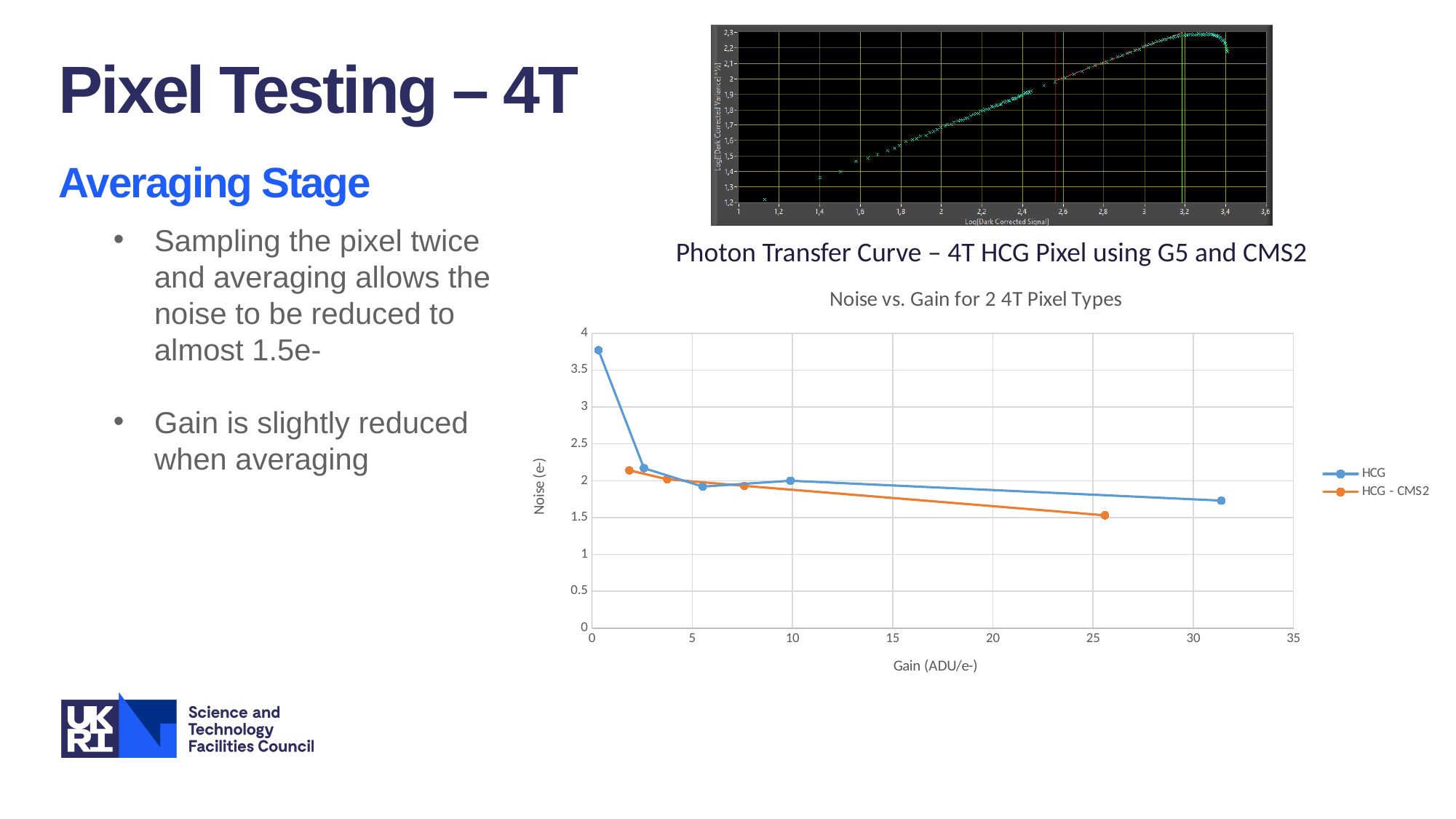
In the 'Noise vs. Gain for 2 4T Pixel Types' chart, how many data points are plotted for the HCG series? 5 In the 'Noise vs. Gain for 2 4T Pixel Types' chart, does the noise for the HCG - CMS2 series rise or fall as gain increases? fall In the 'Noise vs. Gain for 2 4T Pixel Types' chart, how many data points are plotted for the HCG - CMS2 series? 4 In the 'Noise vs. Gain for 2 4T Pixel Types' chart, which series has the highest noise value plotted? HCG In the 'Noise vs. Gain for 2 4T Pixel Types' chart, what is the x-axis label? Gain (ADU/e-) In the 'Noise vs. Gain for 2 4T Pixel Types' chart, is the noise of the first HCG point (at the lowest gain) greater or less than 3.5? greater In the 'Noise vs. Gain for 2 4T Pixel Types' chart, is the noise of the HCG point at a gain of about 10 greater or less than 2.5? less In the 'Noise vs. Gain for 2 4T Pixel Types' chart, which series reaches the lower noise value at its highest-gain point? HCG - CMS2 In the 'Noise vs. Gain for 2 4T Pixel Types' chart, is the noise of the HCG - CMS2 point at the highest gain greater or less than 2? less In the 'Noise vs. Gain for 2 4T Pixel Types' chart, what kind of chart is shown? line chart In the 'Noise vs. Gain for 2 4T Pixel Types' chart, how many series does the legend list? 2 In the 'Noise vs. Gain for 2 4T Pixel Types' chart, what are the two legend entries? HCG and HCG - CMS2